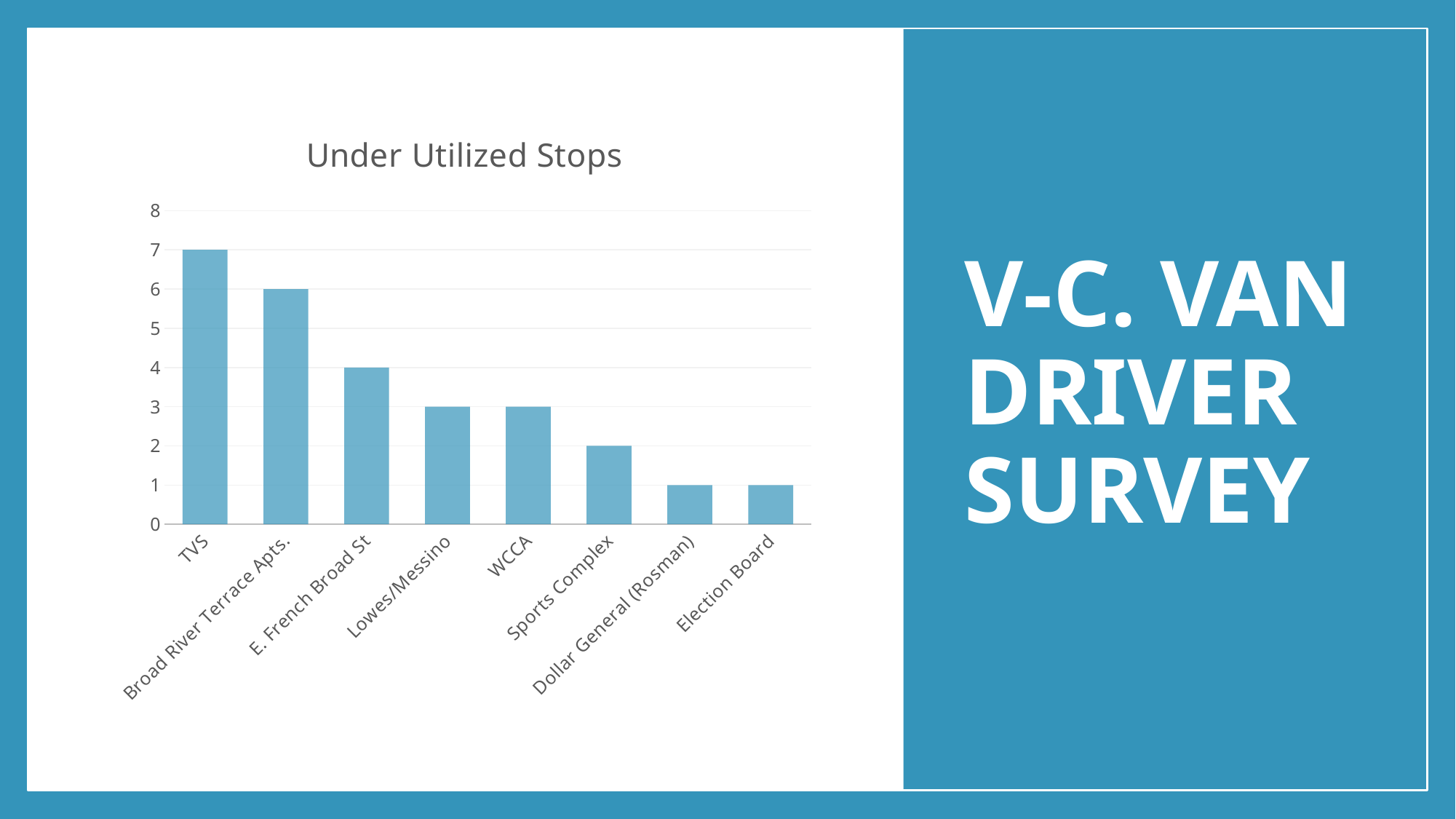
What is the difference between the values for TVS and E. French Broad St? 3 How many stops are shown in the chart? 8 Which stop has the highest value in the chart? TVS What is the title of the chart? Under Utilized Stops Which has a larger value, Broad River Terrace Apts. or WCCA? Broad River Terrace Apts. What is the value for Sports Complex? 2 What is the value for E. French Broad St? 4 What is the value for TVS in the Under Utilized Stops chart? 7 What is the value for Dollar General (Rosman)? 1 What is the value for Broad River Terrace Apts.? 6 Do the values rise or fall moving from left to right along the x axis? Fall What kind of chart is shown on the slide? Bar chart